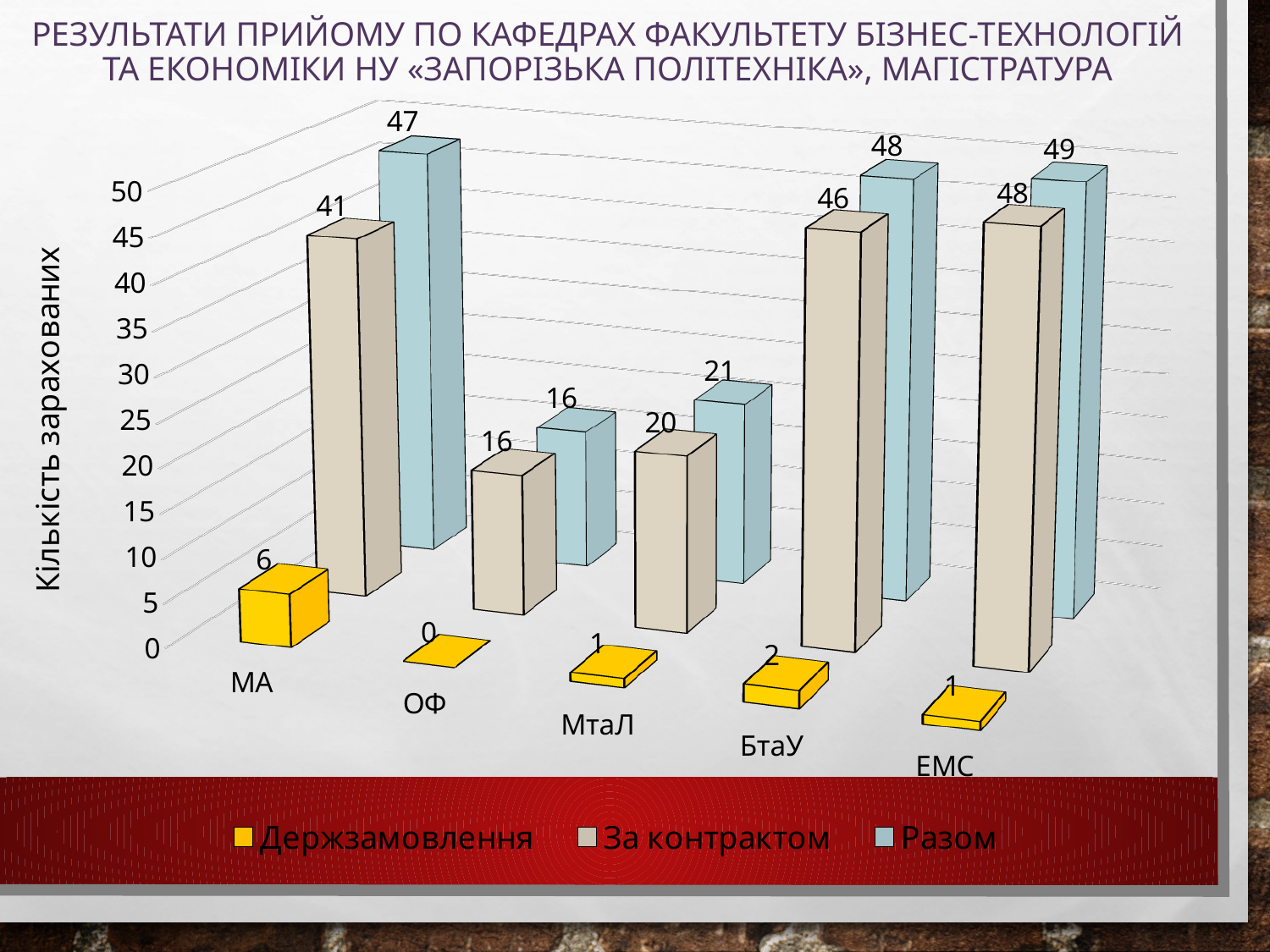
What kind of chart is shown on the slide? bar chart What is the label of the vertical axis? Кількість зарахованих Which category has the lowest value for За контрактом? ОФ What is the value of Разом for МтаЛ? 21 What is the value of Разом for ЕМС? 49 What is the value of За контрактом for БтаУ? 46 How many series does the legend list? 3 Which is larger: За контрактом for ЕМС or За контрактом for БтаУ? За контрактом for ЕМС Which category has the highest value for Разом? ЕМС What is the difference between Разом and За контрактом for МА? 6 What is the value of Держзамовлення for МА? 6 How many categories are shown on the x axis? 5